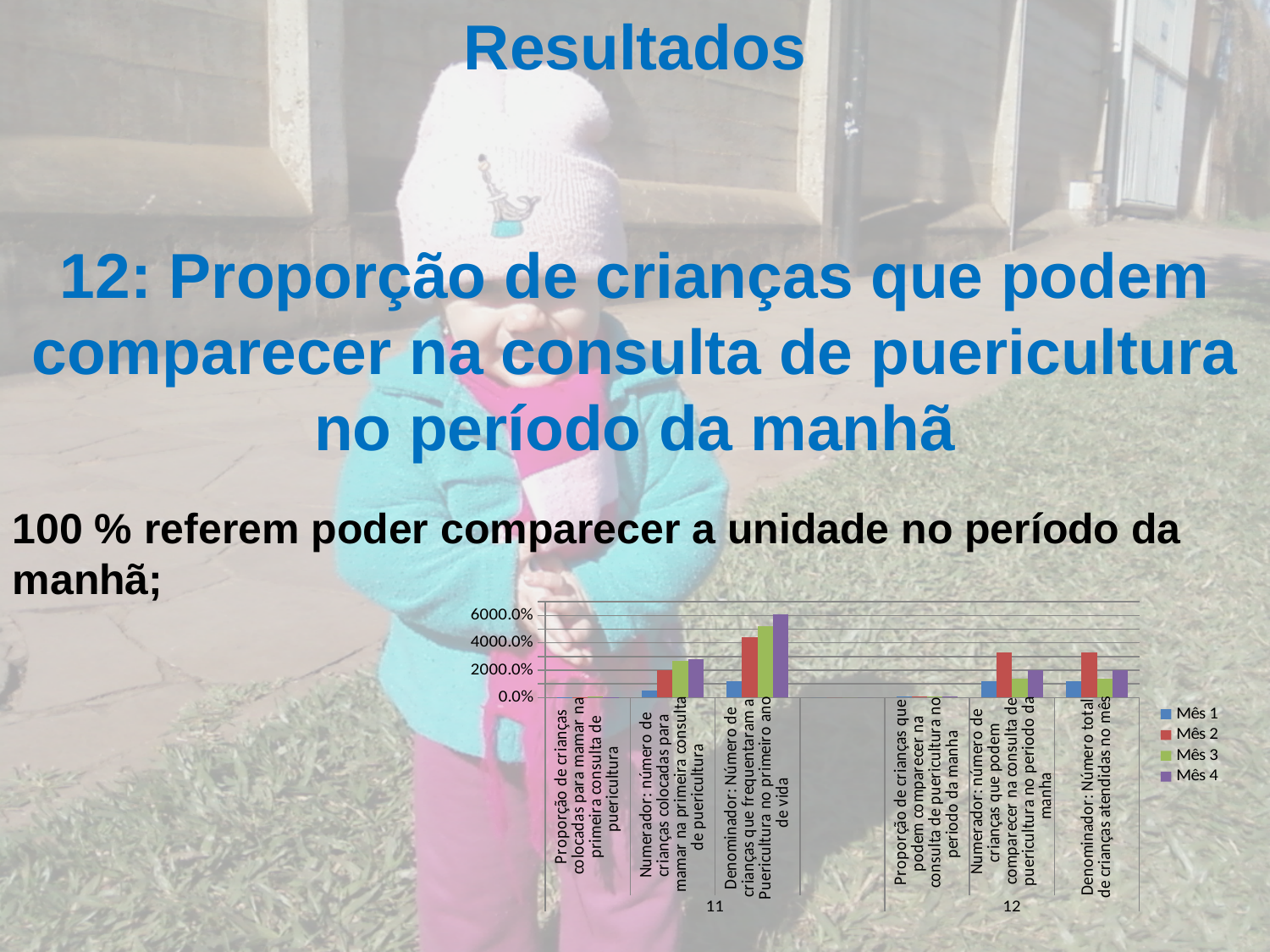
Which series has the shortest bar for the category 'Denominador: Número de crianças que frequentaram a Puericultura no primeiro ano de vida'? Mês 1 What are the two group labels shown beneath the category labels on the x axis? 11 and 12 Do the bars for 'Denominador: Número de crianças que frequentaram a Puericultura no primeiro ano de vida' rise or fall from Mês 1 to Mês 4? rise How many series does the chart legend list? 4 How many categories are shown along the x axis of the chart? 6 Is the Mês 1 value for 'Numerador: número de crianças colocadas para mamar na primeira consulta de puericultura' greater or less than 2000.0%? less Is the Mês 3 value for 'Denominador: Número de crianças que frequentaram a Puericultura no primeiro ano de vida' greater or less than 4000.0%? greater Is the Mês 2 value for 'Numerador: número de crianças que podem comparecer na consulta de puericultura no período da manhã' greater or less than 2000.0%? greater Which series has the tallest bar for the category 'Denominador: Número de crianças que frequentaram a Puericultura no primeiro ano de vida'? Mês 4 What are the series names listed in the chart legend? Mês 1, Mês 2, Mês 3, Mês 4 For the category 'Denominador: Número total de crianças atendidas no mês', which is larger, the Mês 2 value or the Mês 1 value? Mês 2 What kind of chart is shown on the slide? bar chart